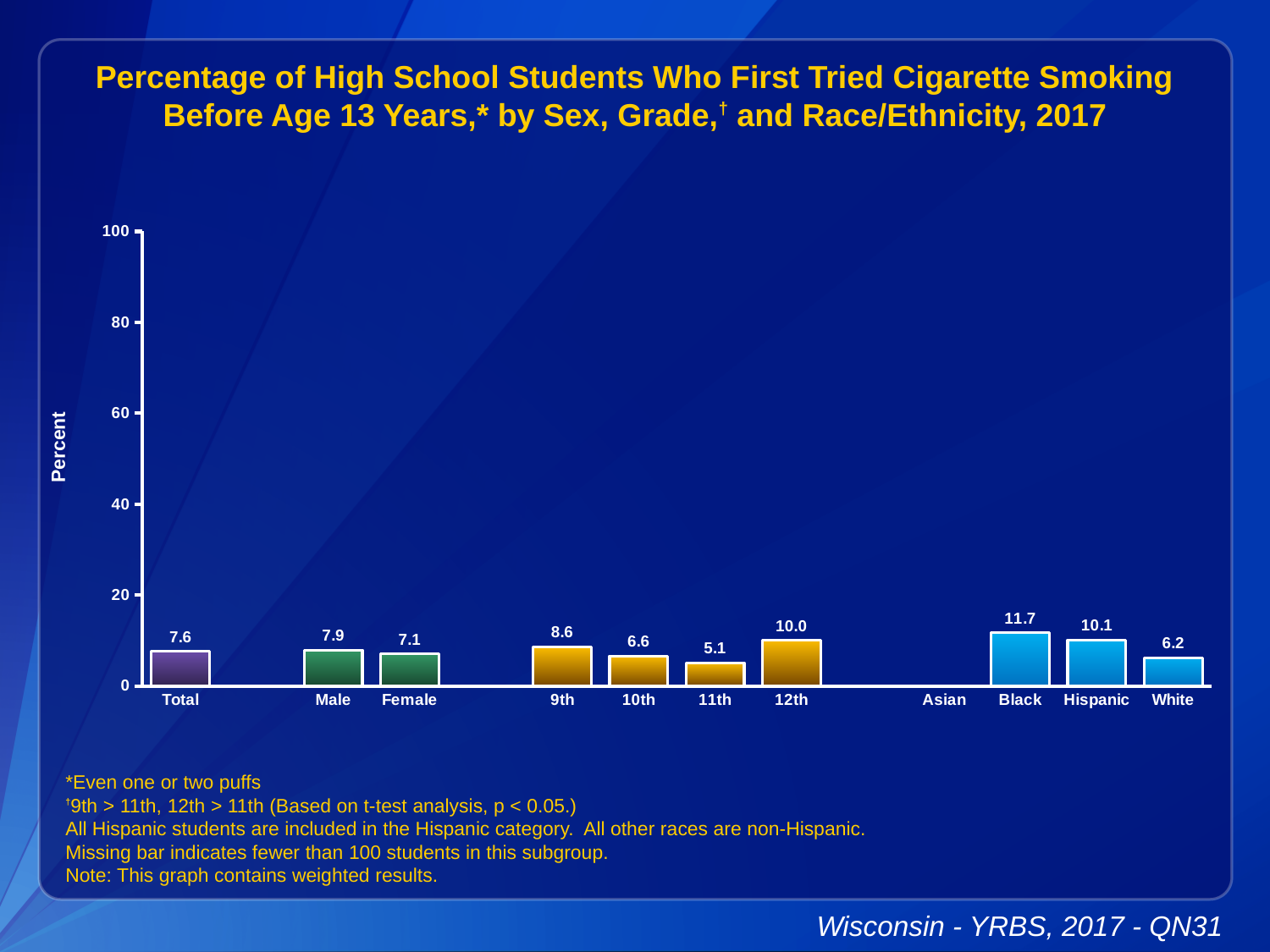
What is the value for 11th grade? 5.1 What kind of chart is shown on the slide? bar chart What is the difference between the values for 12th grade and 9th grade? 1.4 Is the value for Black greater or less than 20? less Which category has the highest value? Black What is the value for Male? 7.9 Which category has no bar shown? Asian What is the value for Hispanic students? 10.1 What is the value for Total? 7.6 Which is larger, the value for 10th grade or the value for White? 10th Which category has the lowest value among those with a bar shown? 11th What is the difference between the values for Male and Female? 0.8